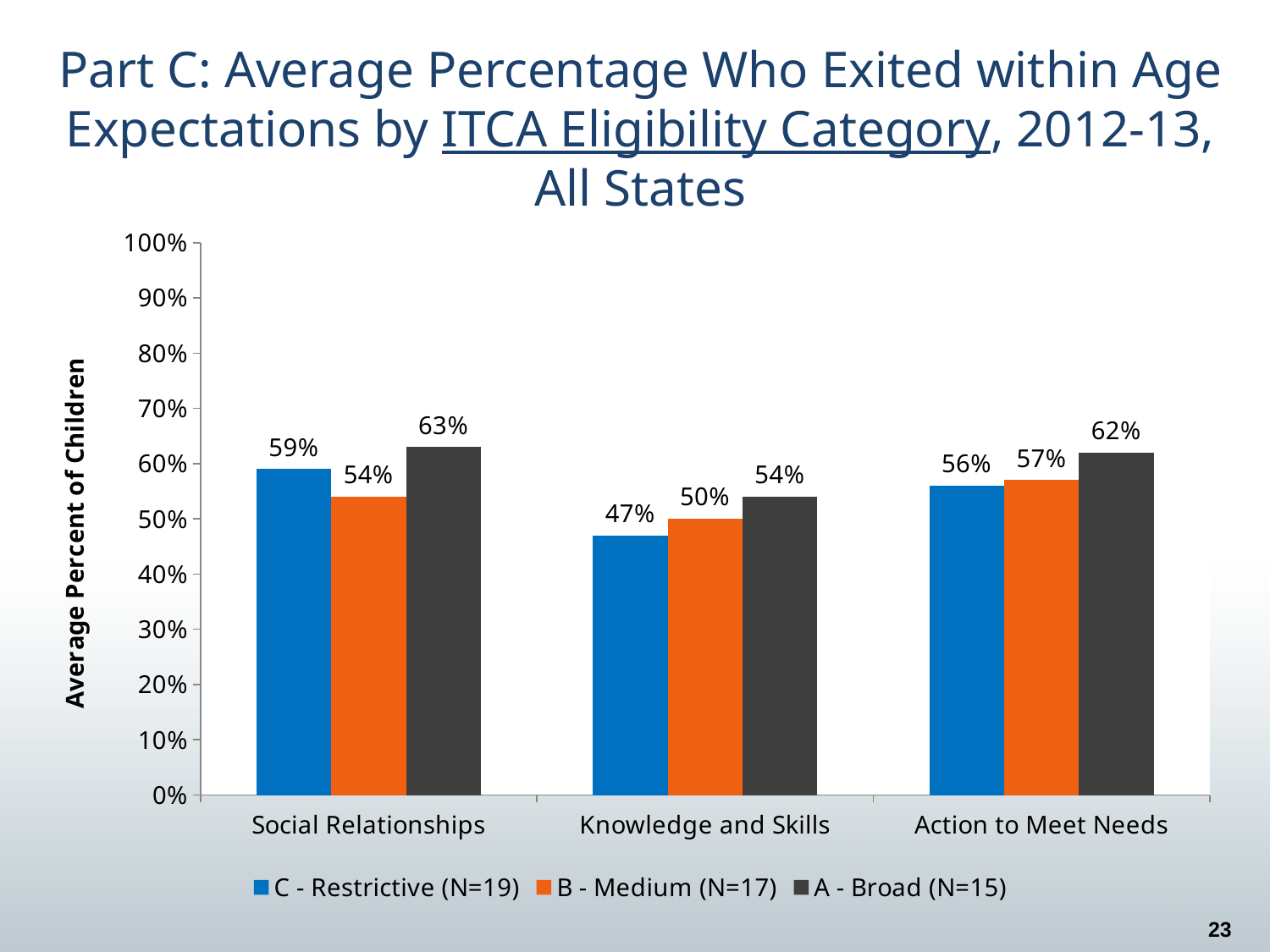
What is the label of the vertical axis? Average Percent of Children Which eligibility category has the lowest value for Social Relationships? B - Medium (N=17) What is the value for C - Restrictive (N=19) in the Knowledge and Skills category? 47% How many outcome categories are shown on the x axis? 3 How many series does the legend list? 3 What is the difference between A - Broad (N=15) and C - Restrictive (N=19) in the Knowledge and Skills category? 7% What kind of chart is shown on the slide? bar chart Is the value for C - Restrictive (N=19) in Knowledge and Skills greater or less than 50%? less Which eligibility category has the highest value for Knowledge and Skills? A - Broad (N=15) Which is larger for Action to Meet Needs: C - Restrictive (N=19) or A - Broad (N=15)? A - Broad (N=15) What is the value for B - Medium (N=17) in the Action to Meet Needs category? 57% What is the value for A - Broad (N=15) in the Social Relationships category? 63%